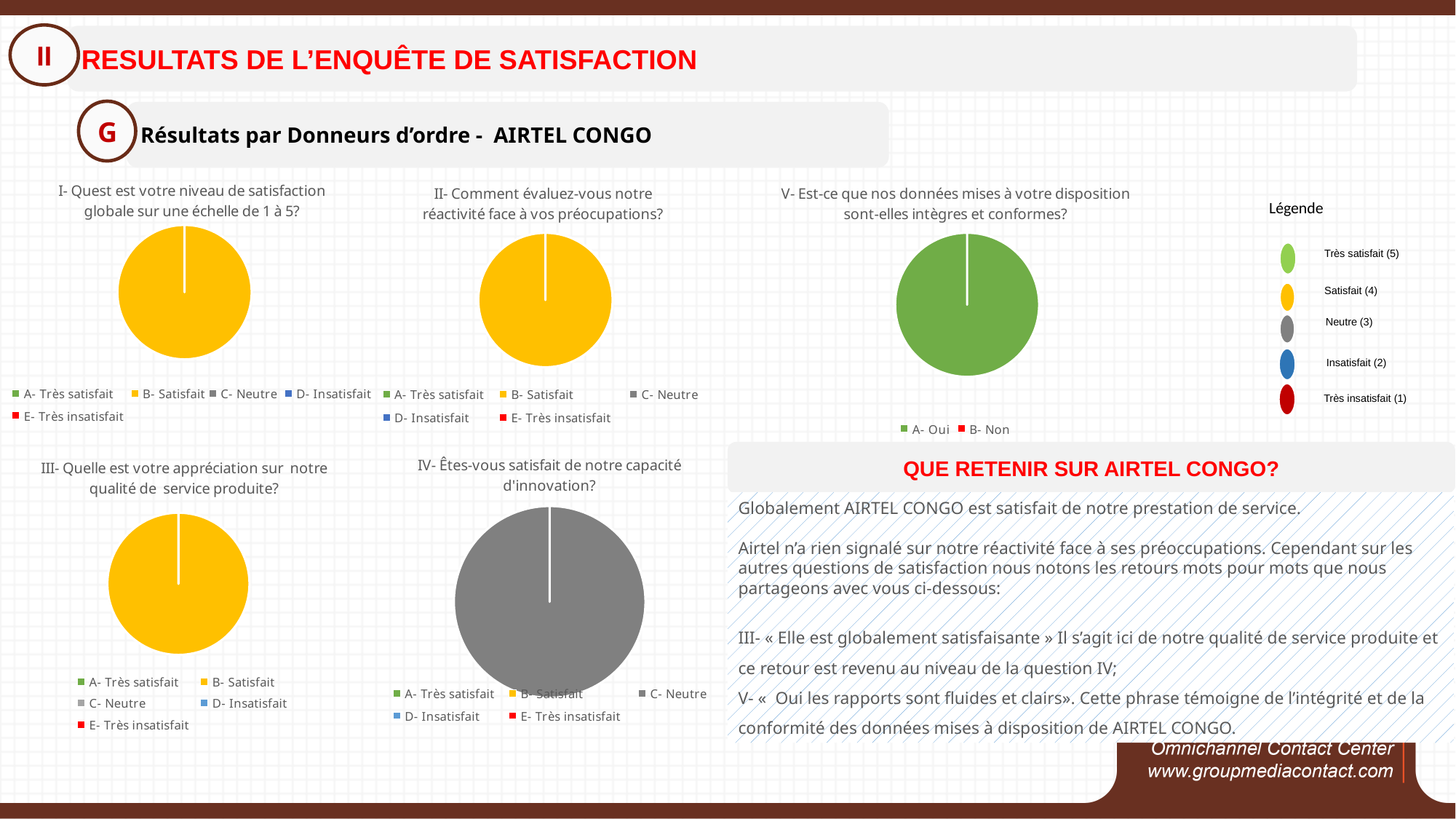
How many entries does the legend list for the chart "V- Est-ce que nos données mises à votre disposition sont-elles intègres et conformes?"? 2 How many entries does the legend list for the chart "I- Quest est votre niveau de satisfaction globale sur une échelle de 1 à 5?"? 5 What colour is the pie in the chart "V- Est-ce que nos données mises à votre disposition sont-elles intègres et conformes?"? Green In the chart "I- Quest est votre niveau de satisfaction globale sur une échelle de 1 à 5?", which category has the largest slice? B- Satisfait What colour is the pie in the chart "IV- Êtes-vous satisfait de notre capacité d'innovation?"? Grey In the chart "II- Comment évaluez-vous notre réactivité face à vos préocupations?", which category has the largest slice? B- Satisfait In the chart "IV- Êtes-vous satisfait de notre capacité d'innovation?", which category has the largest slice? C- Neutre What kind of chart is used for "I- Quest est votre niveau de satisfaction globale sur une échelle de 1 à 5?"? Pie chart How many entries does the legend list for the chart "IV- Êtes-vous satisfait de notre capacité d'innovation?"? 5 How many pie charts are shown on the slide? 5